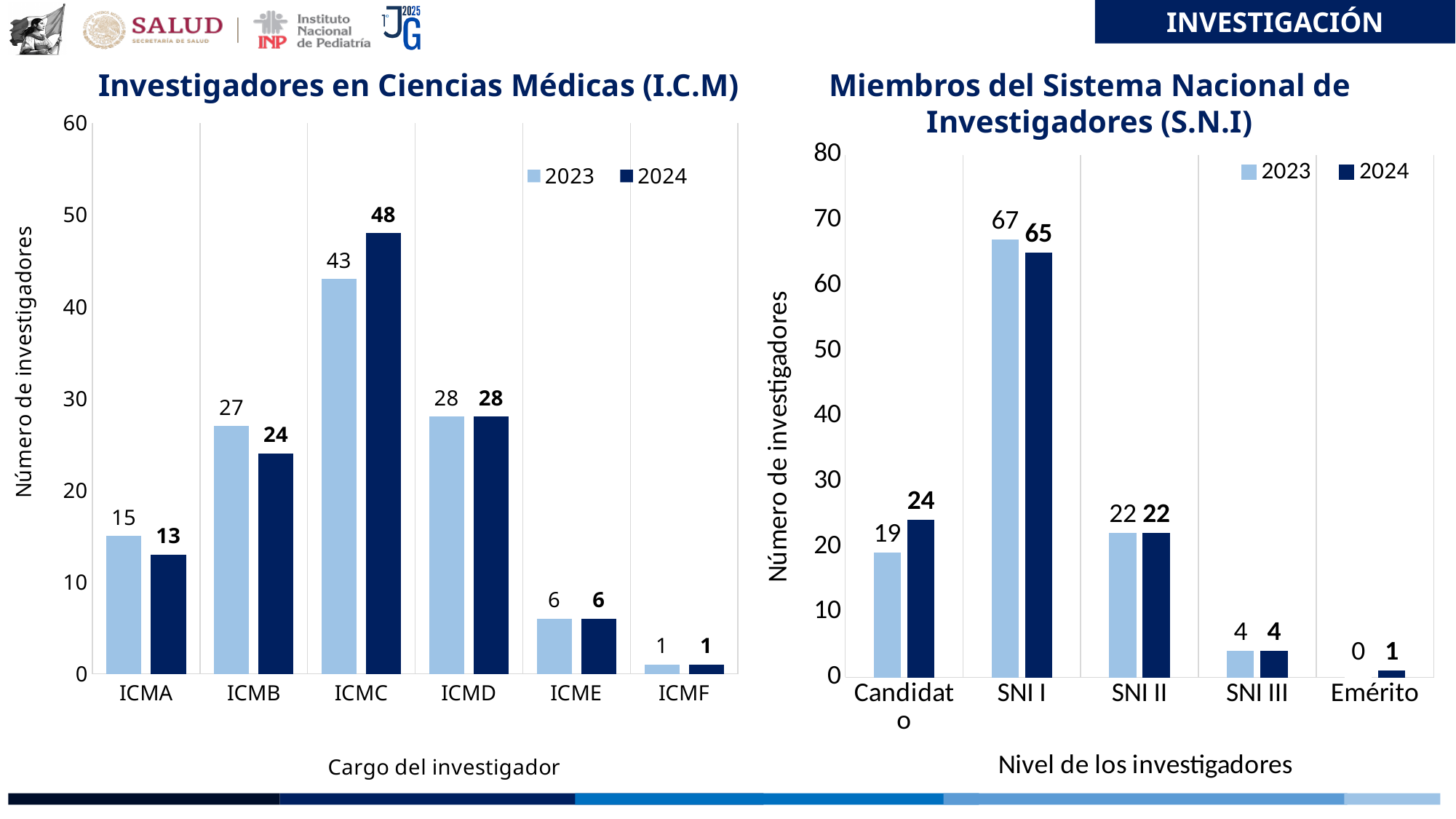
In the 'Miembros del Sistema Nacional de Investigadores (S.N.I)' chart, how many series does the legend list? 2 In the 'Investigadores en Ciencias Médicas (I.C.M)' chart, how many categories are shown on the x axis? 6 In the 'Investigadores en Ciencias Médicas (I.C.M)' chart, which category has the lowest value in 2024? ICMF In the 'Miembros del Sistema Nacional de Investigadores (S.N.I)' chart, what is the value for Candidato in 2024? 24 What kind of chart is the 'Miembros del Sistema Nacional de Investigadores (S.N.I)' chart? Bar chart In the 'Investigadores en Ciencias Médicas (I.C.M)' chart, what is the value for ICMC in 2024? 48 In the 'Miembros del Sistema Nacional de Investigadores (S.N.I)' chart, what is the value for SNI I in 2023? 67 In the 'Miembros del Sistema Nacional de Investigadores (S.N.I)' chart, what is the difference between the 2023 and 2024 values for SNI I? 2 In the 'Investigadores en Ciencias Médicas (I.C.M)' chart, which category has the highest value in 2023? ICMC In the 'Investigadores en Ciencias Médicas (I.C.M)' chart, what is the difference between the 2024 and 2023 values for ICMC? 5 In the 'Investigadores en Ciencias Médicas (I.C.M)' chart, what is the value for ICMB in 2023? 27 In the 'Miembros del Sistema Nacional de Investigadores (S.N.I)' chart, which is larger for Candidato: the 2023 value or the 2024 value? 2024